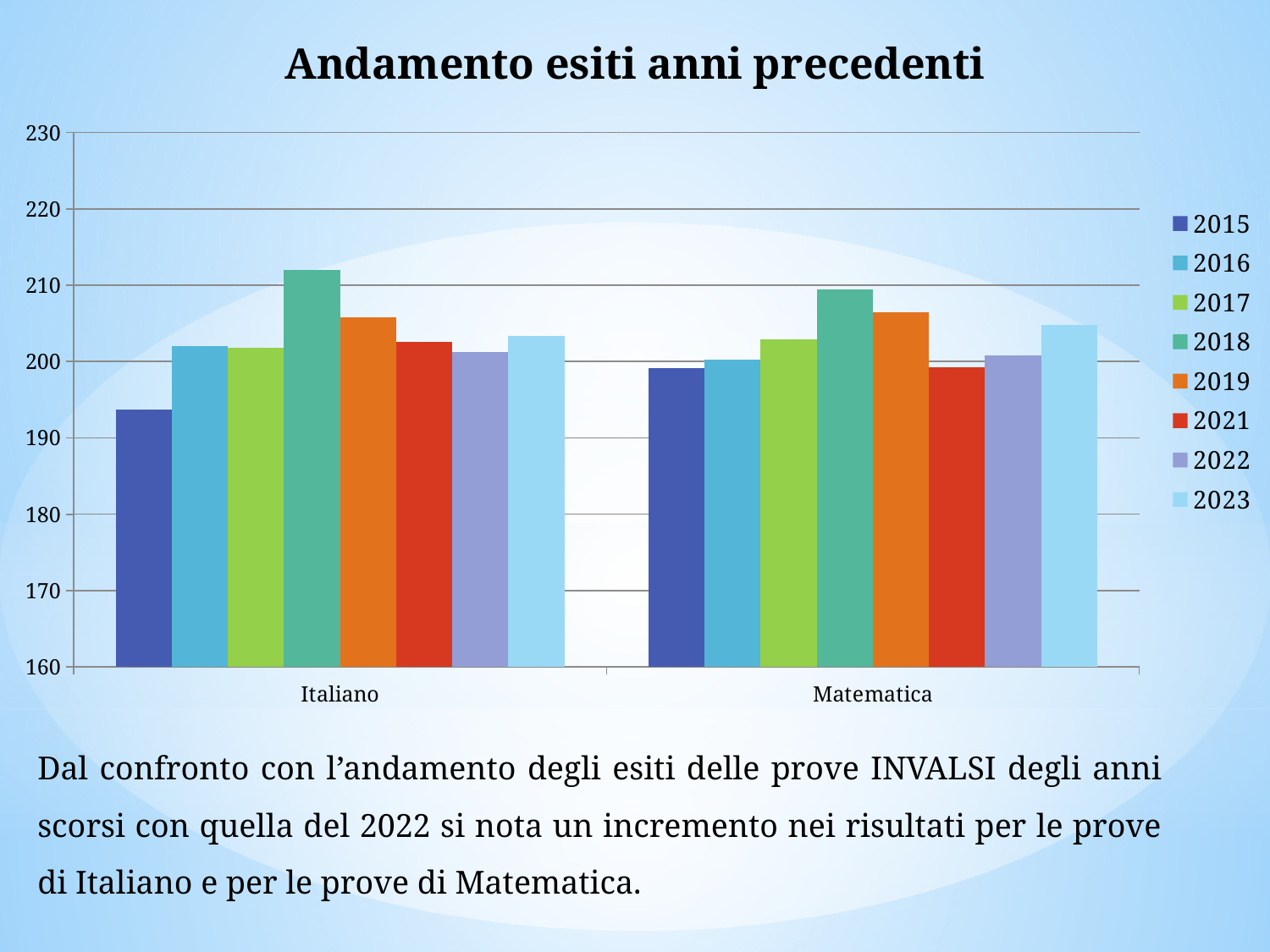
Which is larger, the 2015 value for Italiano or the 2015 value for Matematica? Matematica Is the value for Italiano in 2018 greater or less than 210? greater Which year has the highest value for Italiano? 2018 Is the value for Matematica in 2019 greater or less than 200? greater Is the value for Italiano in 2015 greater or less than 200? less What kind of chart is shown on the slide? bar chart Which year has the lowest value for Italiano? 2015 How many series does the legend list? 8 Which year has the highest value for Matematica? 2018 Which is larger for Italiano, the 2019 value or the 2021 value? 2019 How many categories are shown on the x axis? 2 What is the title of the chart? Andamento esiti anni precedenti